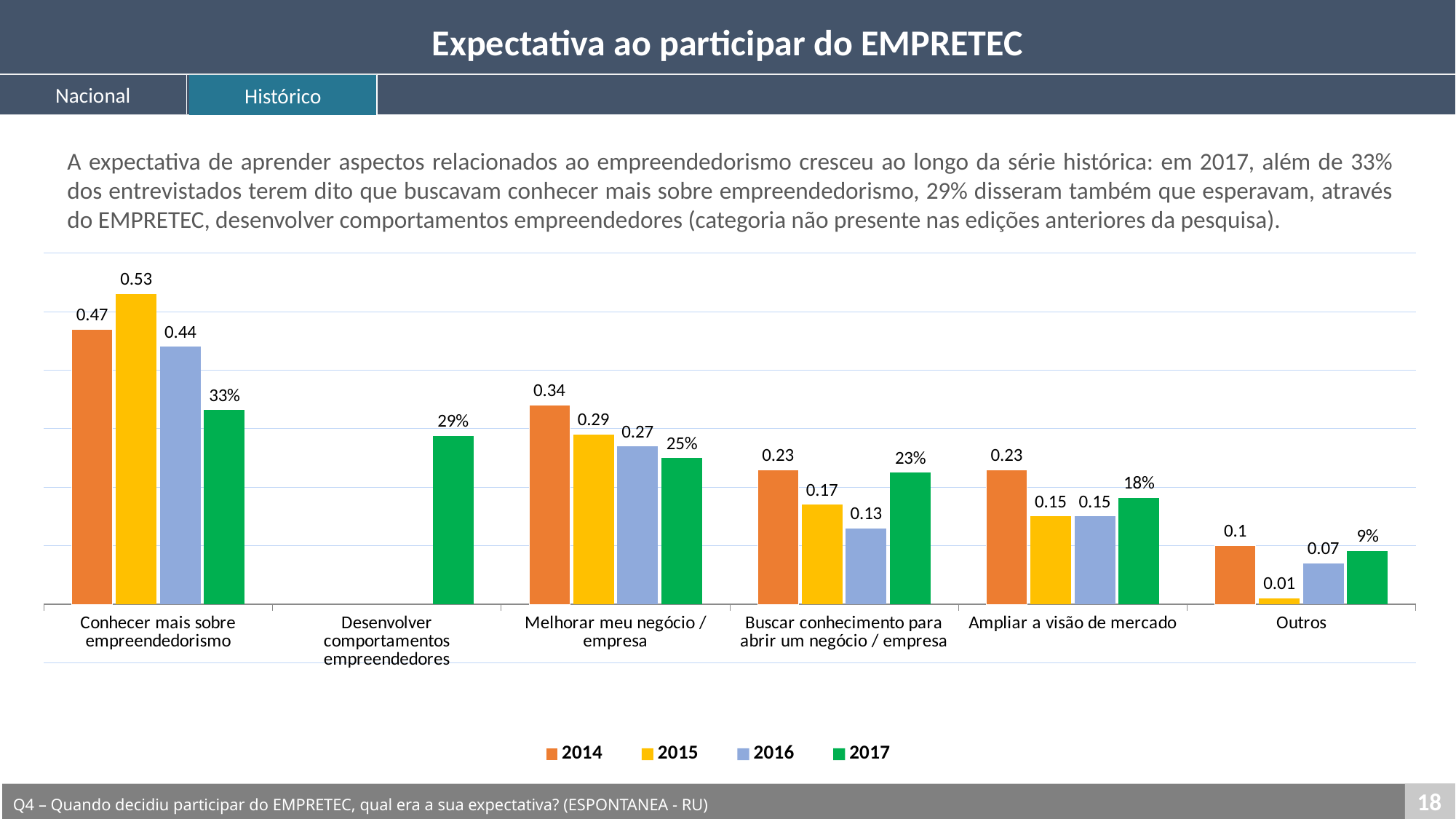
How many categories are shown on the x axis of the chart? 6 How many series does the legend list? 4 What is the difference between the 2015 and 2014 values in the "Conhecer mais sobre empreendedorismo" category? 0.06 What is the value for 2015 in the "Outros" category? 0.01 What is the value for 2017 in the "Desenvolver comportamentos empreendedores" category? 29% Which category has the lowest value for the 2017 series? Outros What is the value for 2015 in the "Conhecer mais sobre empreendedorismo" category? 0.53 What is the value for 2014 in the "Melhorar meu negócio / empresa" category? 0.34 Do the values for "Melhorar meu negócio / empresa" rise or fall from 2014 to 2017? fall What is the value for 2016 in the "Buscar conhecimento para abrir um negócio / empresa" category? 0.13 Which category has the highest value for the 2014 series? Conhecer mais sobre empreendedorismo In the "Ampliar a visão de mercado" category, which is larger: the 2014 value or the 2016 value? 2014